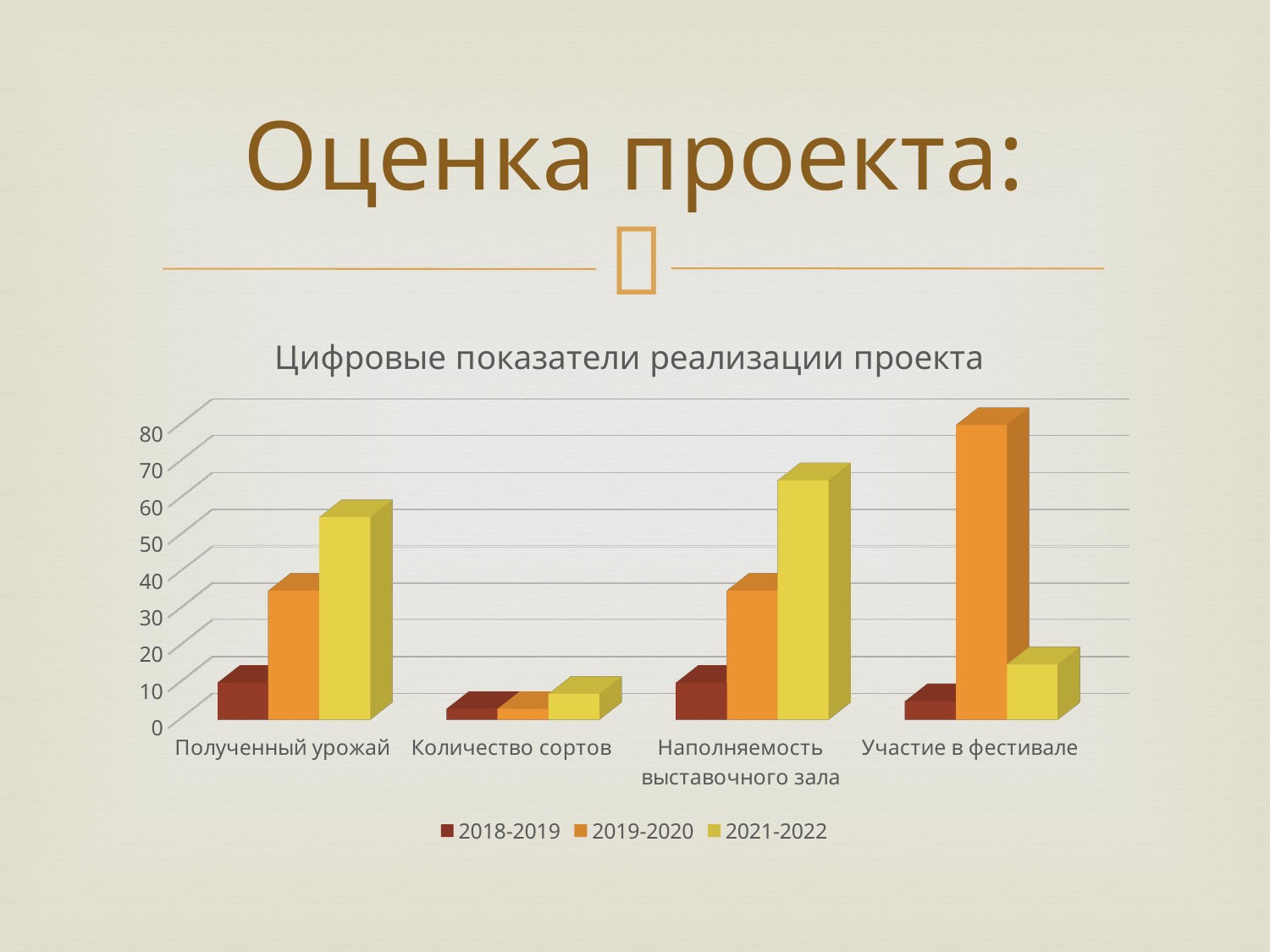
How many series does the legend list? 3 For Участие в фестивале, which series has the larger value: 2019-2020 or 2021-2022? 2019-2020 Which series is shown in yellow in the legend? 2021-2022 Is the value for 2019-2020 in Участие в фестивале greater or less than 70? greater How many categories are shown on the x axis? 4 For Полученный урожай, which series has the larger value: 2019-2020 or 2021-2022? 2021-2022 Which category has the highest bar for the 2021-2022 series? Наполняемость выставочного зала What kind of chart is shown on the slide? bar chart Is the value for 2018-2019 in Полученный урожай greater or less than 20? less What is the title of the chart? Цифровые показатели реализации проекта Which category has the highest bar for the 2019-2020 series? Участие в фестивале Which category has the lowest bar for the 2021-2022 series? Количество сортов